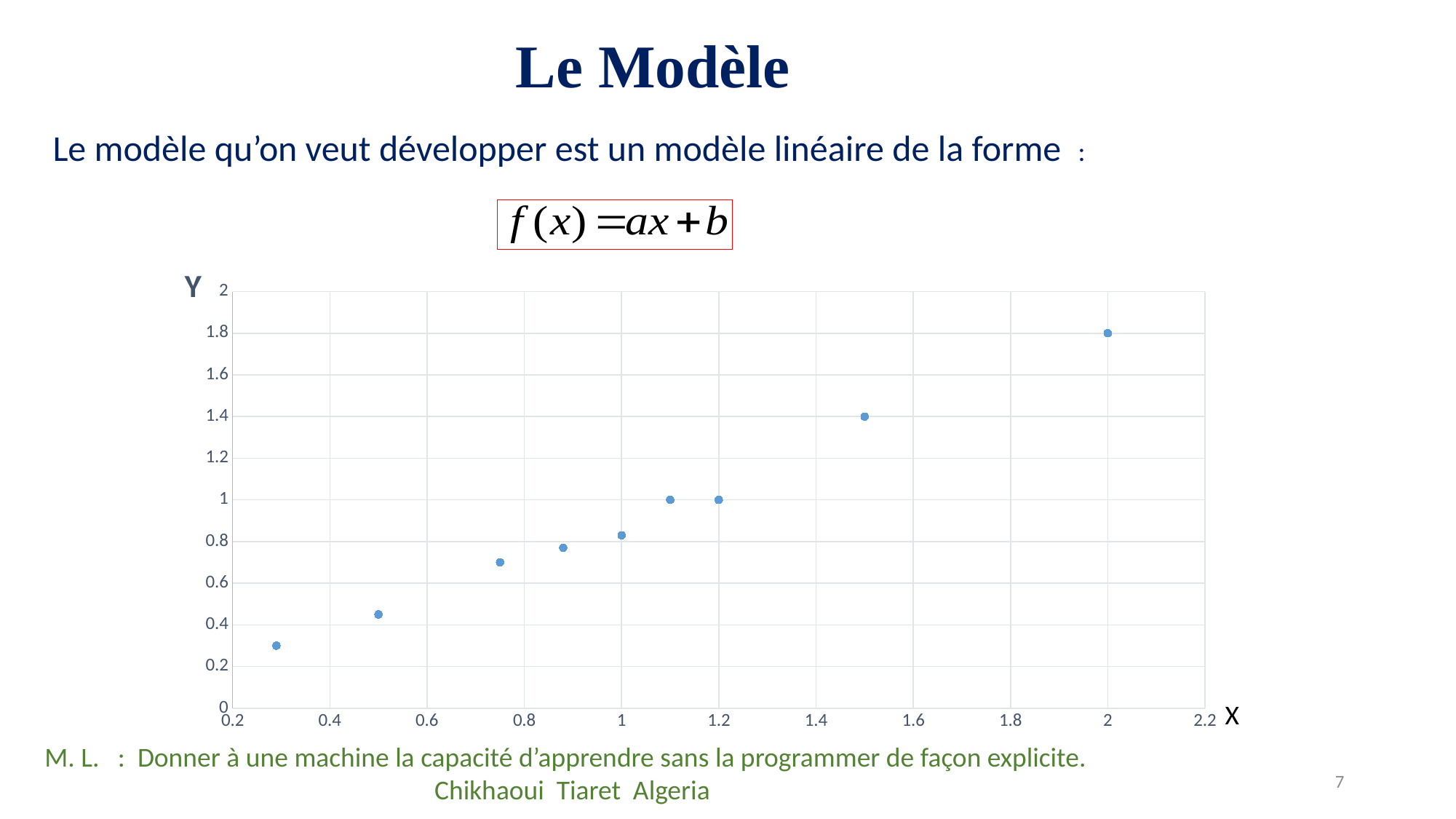
What is the Y value of the point at X = 2? 1.8 Is the Y value of the leftmost point greater or less than 0.4? less Is the Y value of the rightmost point greater or less than 1.6? greater What kind of chart is shown on the slide? scatter chart Is the Y value of the point at X = 1 greater or less than 1? less What is the label of the vertical axis? Y At which X value does the point with the highest Y value lie? 2 How many data points are plotted in the chart? 9 Do the Y values generally rise or fall as X increases? rise What is the label of the horizontal axis? X What is the Y value of the point at X = 1.2? 1 Which point has the highest Y value: the one at X = 2 or the one at X = 1.2? the one at X = 2